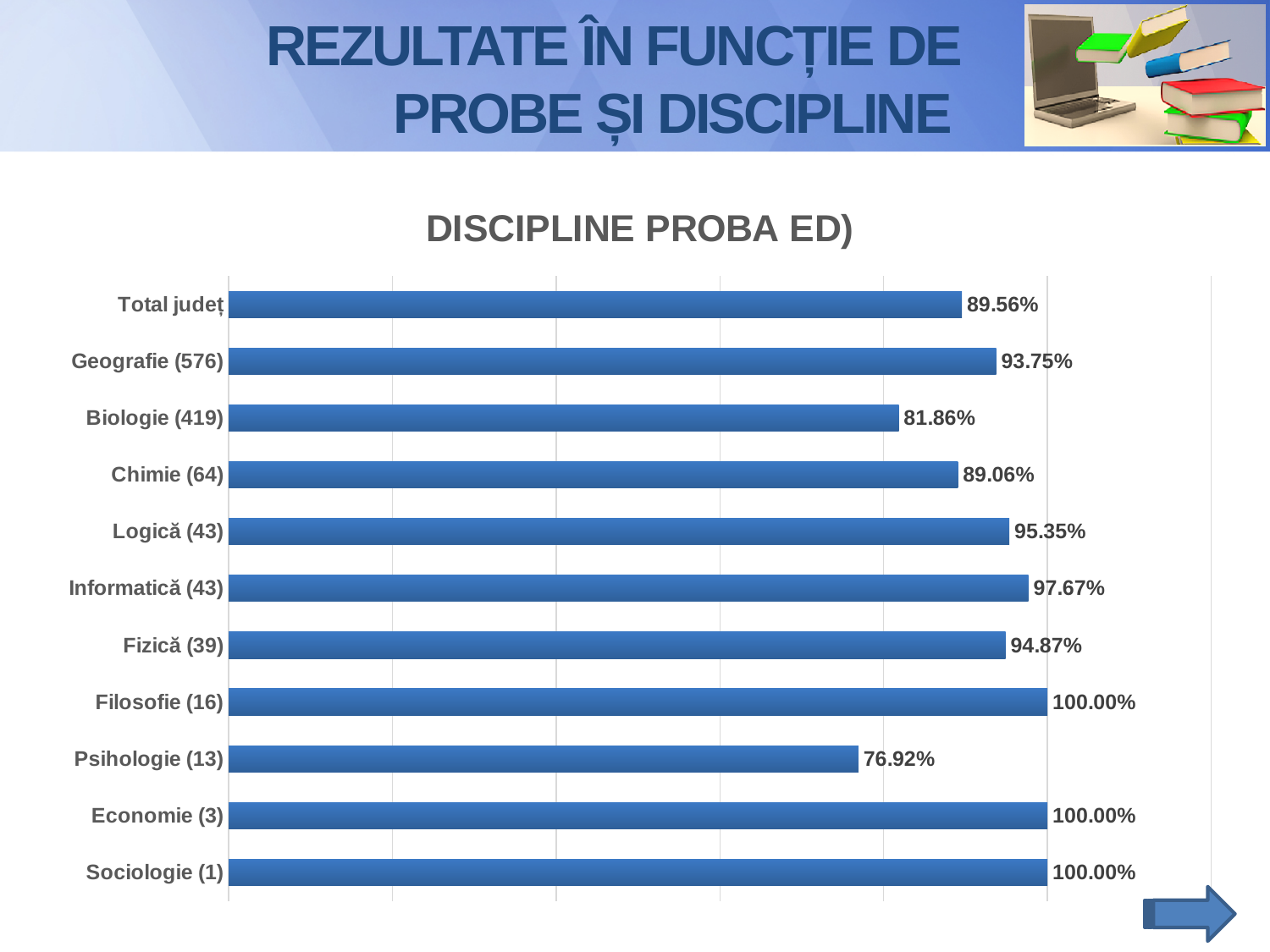
Which category has the lowest value? Psihologie (13) How many categories have a value of 100.00%? 3 What is the difference between the values for Geografie (576) and Biologie (419)? 11.89 percentage points What is the value for Geografie (576)? 93.75% What is the difference between the values for Informatică (43) and Logică (43)? 2.32 percentage points What kind of chart is shown on the slide? Bar chart Which is larger, the value for Chimie (64) or the value for Biologie (419)? Chimie (64) Which is larger, the value for Fizică (39) or the value for Total județ? Fizică (39) What is the value for Psihologie (13)? 76.92% What is the value for Informatică (43)? 97.67% How many categories are shown in the chart? 11 What is the value for Total județ? 89.56%